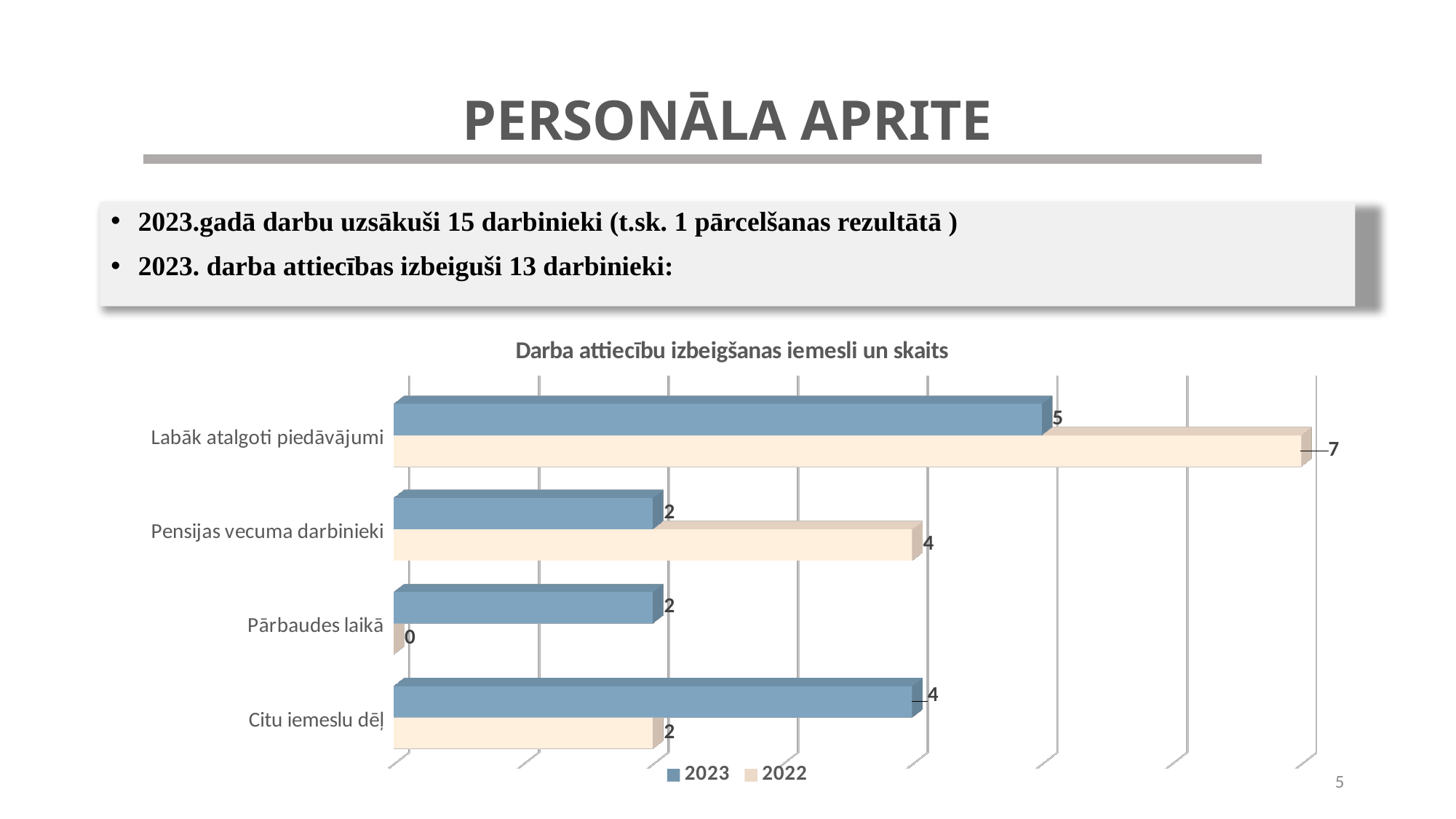
What is the value for Citu iemeslu dēļ in the 2023 series? 4 Which category has the lowest value in the 2022 series? Pārbaudes laikā What is the difference between the 2022 and 2023 values for Labāk atalgoti piedāvājumi? 2 What is the value for Pensijas vecuma darbinieki in the 2022 series? 4 How many categories are shown on the chart? 4 What is the value for Pārbaudes laikā in the 2022 series? 0 What is the value for Labāk atalgoti piedāvājumi in the 2023 series? 5 What is the value for Labāk atalgoti piedāvājumi in the 2022 series? 7 What kind of chart is shown on the slide? Bar chart For Citu iemeslu dēļ, which series has the larger value, 2023 or 2022? 2023 How many series does the legend list? 2 Which category has the highest value in the 2022 series? Labāk atalgoti piedāvājumi